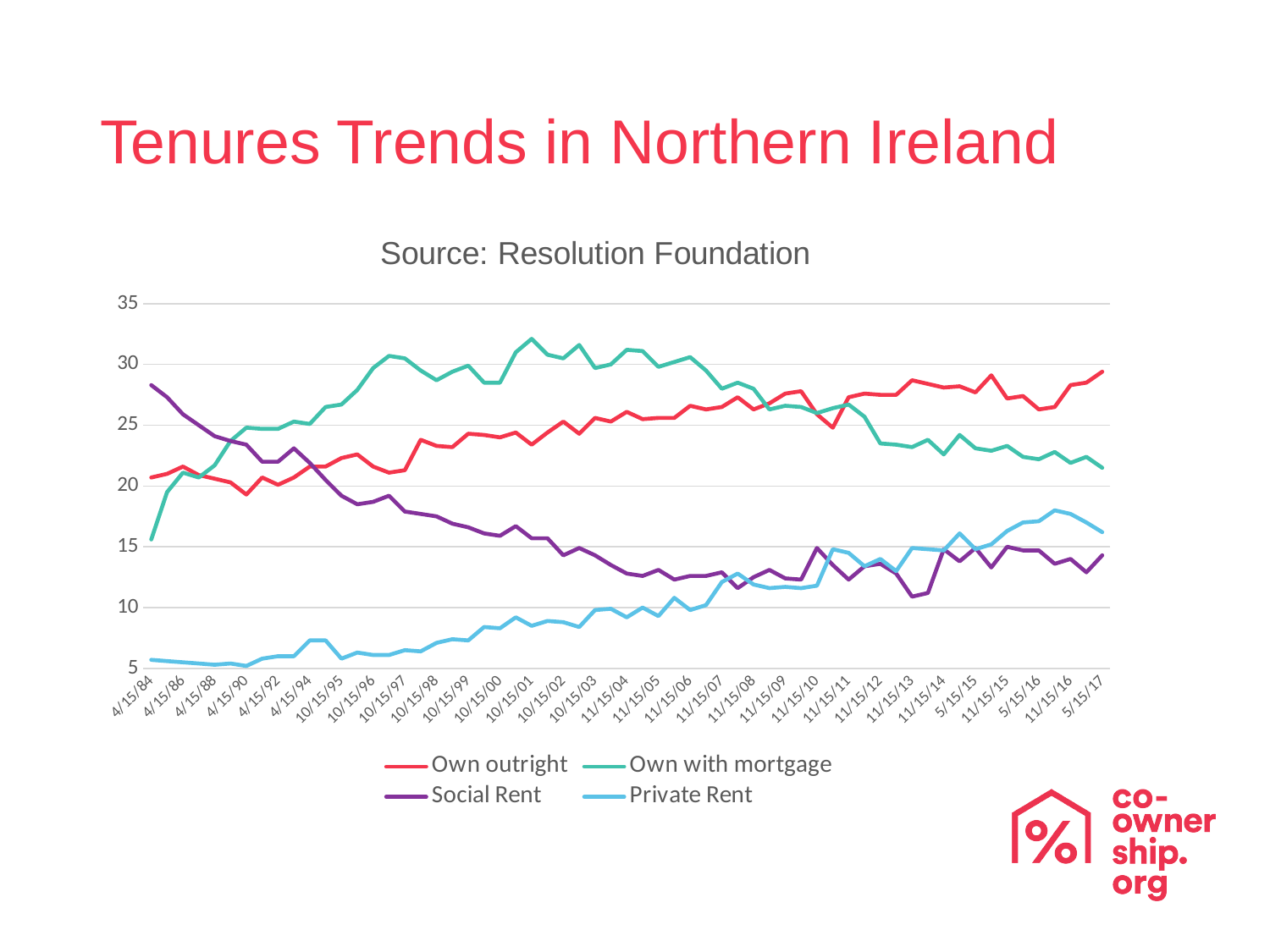
Which colour is used for the Own outright series? red How many series does the chart legend list? 4 Does the Social Rent series rise or fall from 4/15/84 to 5/15/17? fall Which series has the lowest value at 4/15/84? Private Rent What is the title shown above the chart? Source: Resolution Foundation Is the value for Own outright at 5/15/17 greater or less than 25? greater Which series has the highest value at 5/15/17? Own outright Is the value for Social Rent at 4/15/84 greater or less than 25? greater At 4/15/84, which is larger: Own outright or Own with mortgage? Own outright What kind of chart is shown on the slide? line chart Does the Private Rent series rise or fall from 4/15/84 to 5/15/17? rise Is the value for Private Rent at 4/15/84 greater or less than 10? less